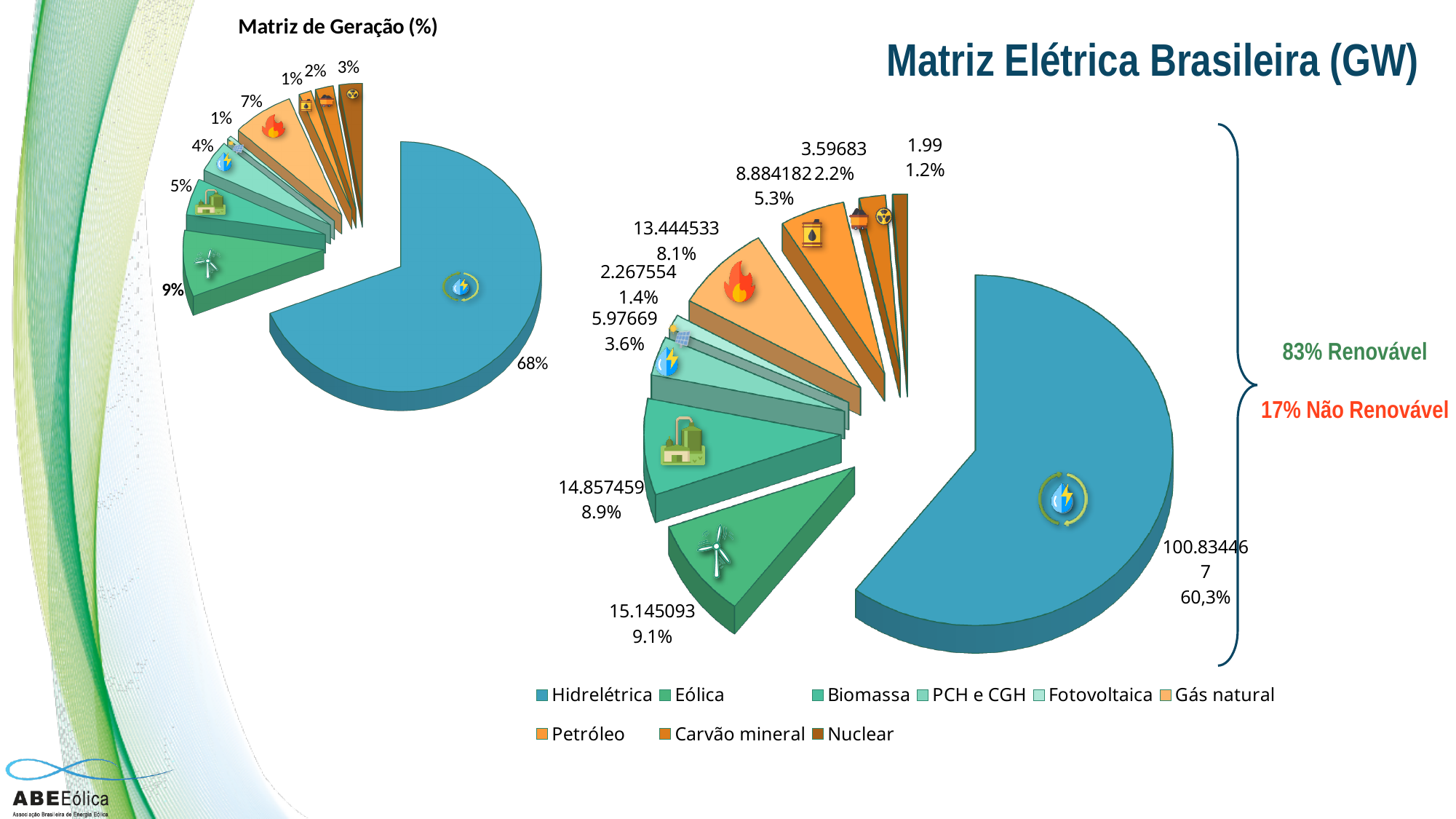
In the 'Matriz Elétrica Brasileira (GW)' chart, which is larger, Petróleo or Carvão mineral? Petróleo In the 'Matriz Elétrica Brasileira (GW)' chart, which source has the largest slice? Hidrelétrica In the 'Matriz Elétrica Brasileira (GW)' chart, what value in GW is shown for Gás natural? 13.444533 What kind of chart is the 'Matriz Elétrica Brasileira (GW)' chart on the right? pie chart According to the text beside the right chart, what share of the matrix is renewable ('Renovável')? 83% How many entries does the legend at the bottom of the slide list? 9 In the 'Matriz de Geração (%)' chart on the left, what percentage is shown for the largest slice (Hidrelétrica)? 68% In the 'Matriz Elétrica Brasileira (GW)' chart, what value in GW is shown for Eólica? 15.145093 In the 'Matriz Elétrica Brasileira (GW)' chart, which source has the smallest slice? Nuclear In the 'Matriz Elétrica Brasileira (GW)' chart, what percentage is shown for Hidrelétrica? 60,3% In the 'Matriz Elétrica Brasileira (GW)' chart, what percentage is shown for Biomassa? 8.9% In the 'Matriz de Geração (%)' chart on the left, what percentage is shown for Eólica? 9%